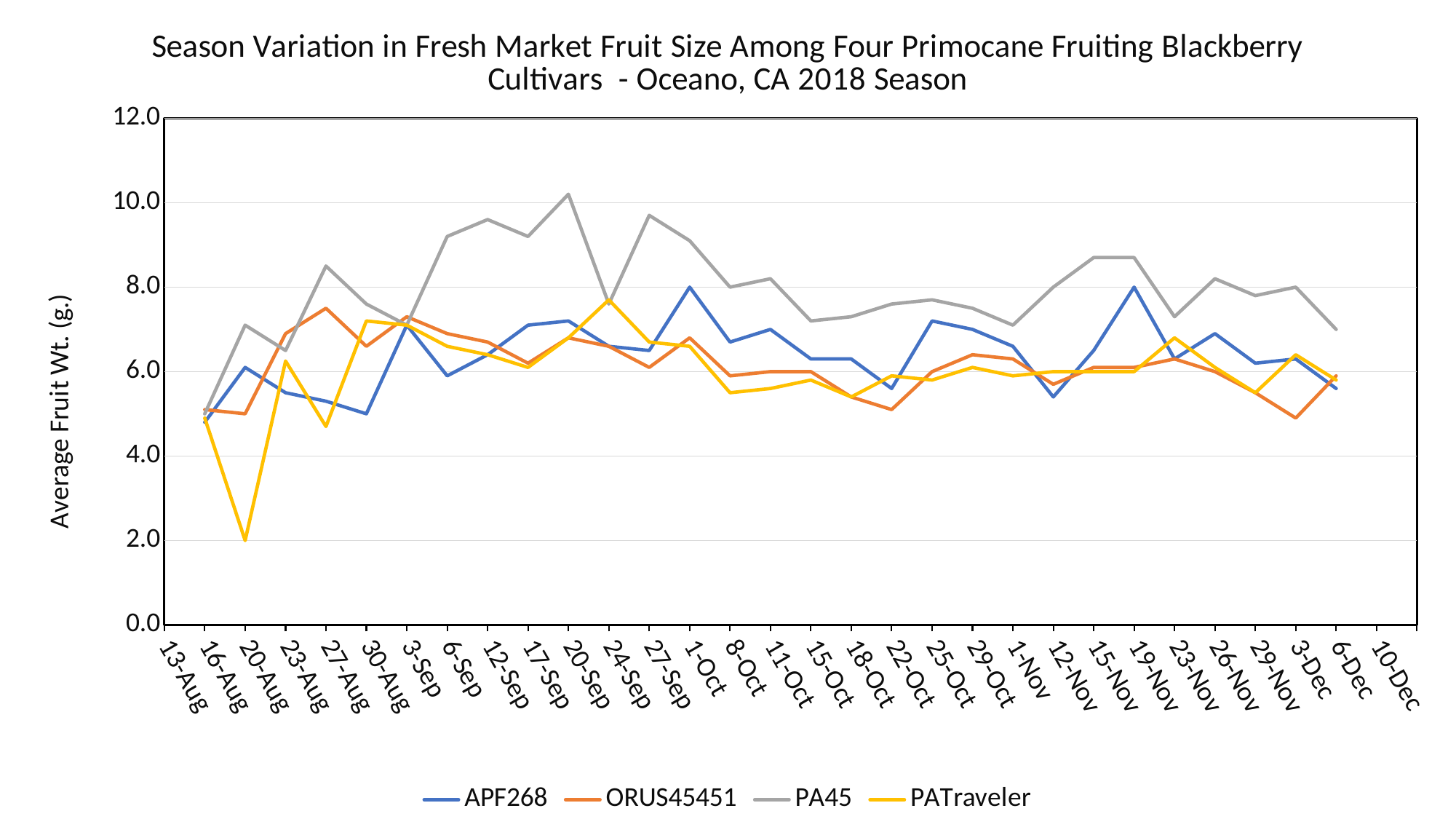
What kind of chart is shown on the slide? line chart Which series has the highest value on 20-Sep? PA45 What is the value for PATraveler on 20-Aug? 2.0 Which colour is used for the PA45 series? grey On 20-Aug, which is larger: APF268 or PATraveler? APF268 How many series does the legend list? 4 Is the value for PA45 on 27-Sep greater or less than 8.0? greater What is the label on the vertical axis? Average Fruit Wt. (g.) Is the value for PA45 on 20-Sep greater or less than 10.0? greater Is the value for APF268 on 30-Aug greater or less than 6.0? less Which series has the lowest value on 20-Aug? PATraveler